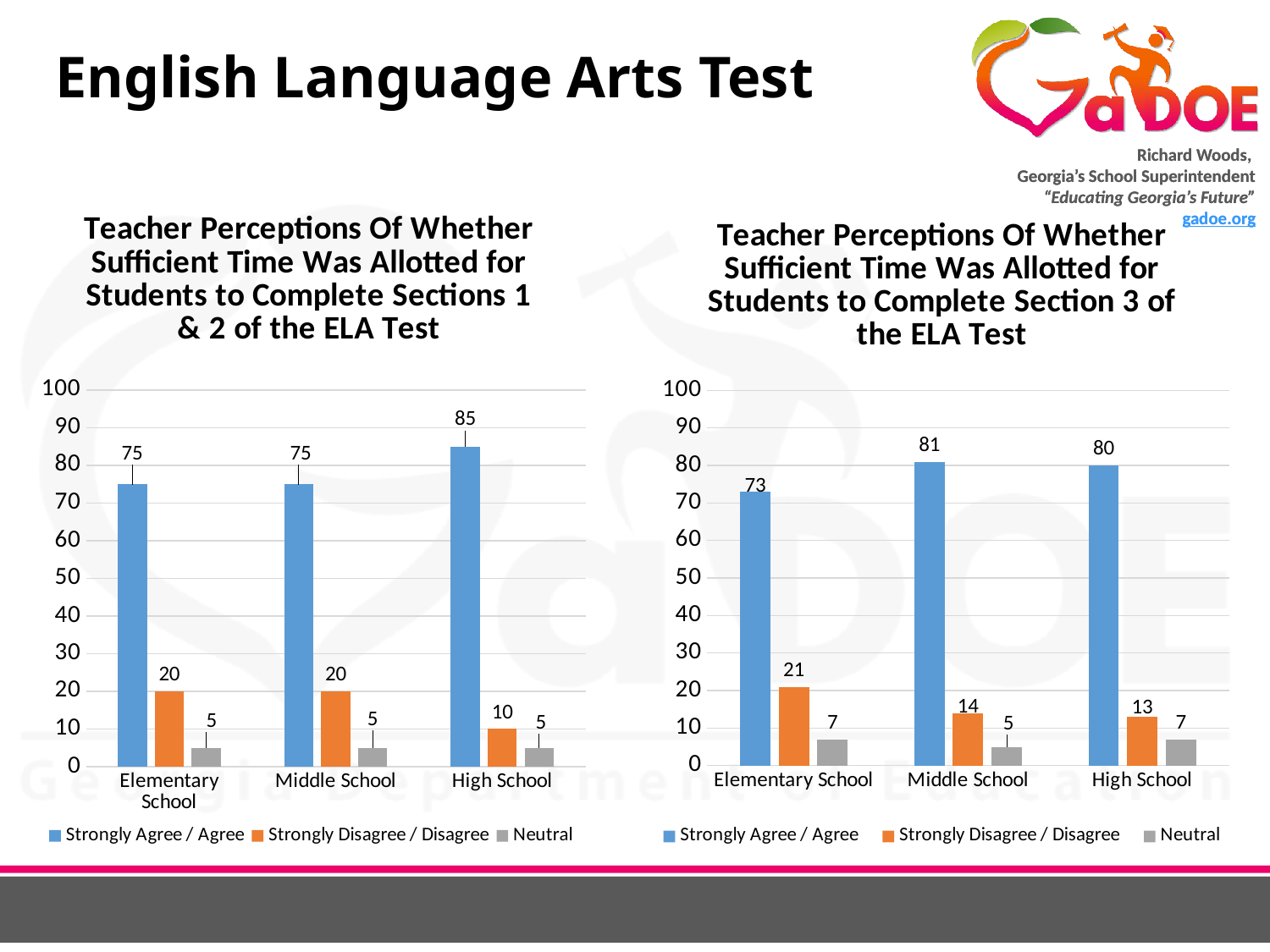
How many series does the legend of the left chart (Sections 1 & 2 of the ELA Test) list? 3 In the left chart (Sections 1 & 2 of the ELA Test), what colour represents the Neutral series? Gray In the left chart (Sections 1 & 2 of the ELA Test), is the Strongly Agree / Agree value for Elementary School greater or less than 70? greater In the right chart (Section 3 of the ELA Test), what is the difference between the Strongly Disagree / Disagree values for Elementary School and High School? 8 How many school levels are shown on the x axis of the right chart (Section 3 of the ELA Test)? 3 In the right chart (Section 3 of the ELA Test), which school level has the highest Strongly Agree / Agree value? Middle School In the left chart (Sections 1 & 2 of the ELA Test), which school level has the lowest Strongly Disagree / Disagree value? High School In the right chart (Section 3 of the ELA Test), what is the Strongly Disagree / Disagree value for Elementary School? 21 In the left chart (Sections 1 & 2 of the ELA Test), what is the difference between the Strongly Agree / Agree values for High School and Middle School? 10 In the left chart (Sections 1 & 2 of the ELA Test), what is the Strongly Agree / Agree value for High School? 85 In the right chart (Section 3 of the ELA Test), which is larger: the Strongly Agree / Agree value for Elementary School or for High School? High School What kind of chart is the right chart (Section 3 of the ELA Test)? Bar chart